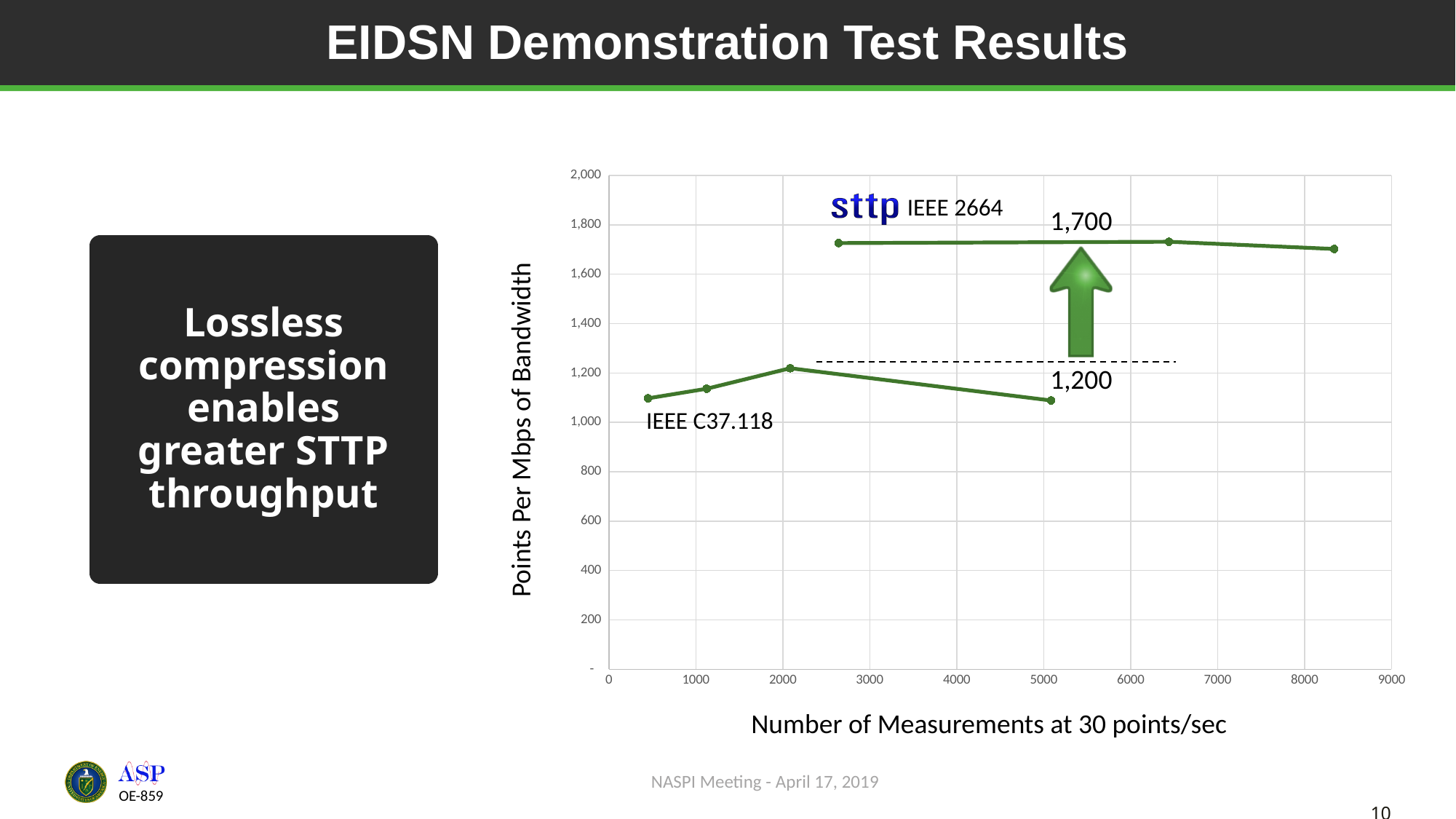
How many lines (series) are plotted on the chart? 2 Are the values on the STTP IEEE 2664 line greater or less than 1,800? less What is the title of the y-axis? Points Per Mbps of Bandwidth What is the highest value shown on the y-axis? 2,000 How many data points are plotted on the IEEE C37.118 line? 4 How many data points are plotted on the STTP IEEE 2664 line? 3 Which series has the higher Points Per Mbps of Bandwidth, IEEE C37.118 or STTP IEEE 2664? STTP IEEE 2664 Is the value for IEEE C37.118 at about 5000 measurements greater or less than 1,000? greater What is the title of the x-axis? Number of Measurements at 30 points/sec Is the value for IEEE C37.118 at about 5000 measurements greater or less than 1,200? less What kind of chart is shown on the slide? line chart